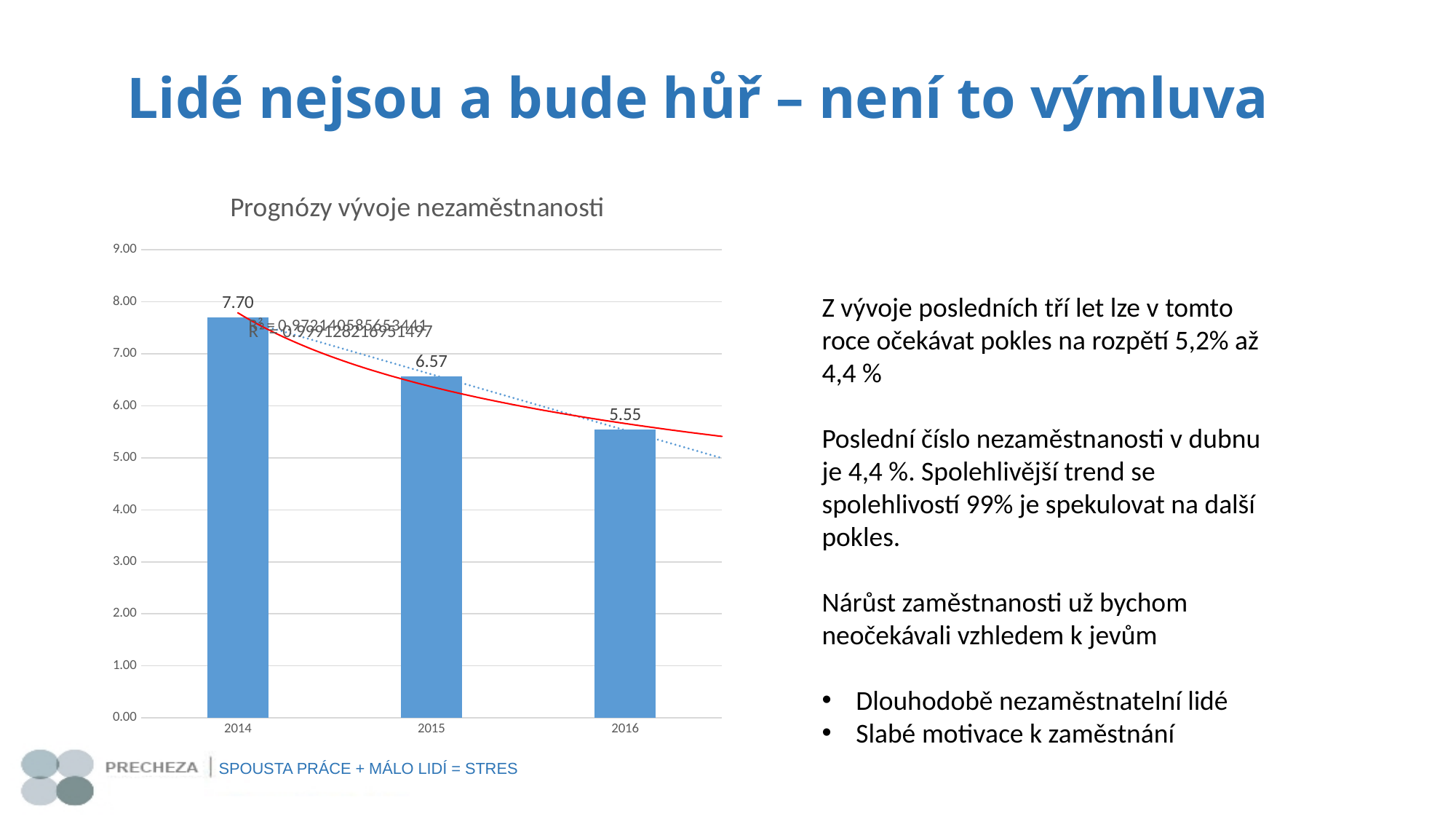
What is the value for 2014? 7.70 How many years are shown on the x axis? 3 Is the value for 2016 greater or less than 6.00? less What is the value for 2016? 5.55 What is the difference between the values for 2014 and 2016? 2.15 What kind of chart is this? bar chart What is the difference between the values for 2014 and 2015? 1.13 Which year has the lowest value? 2016 What is the value for 2015? 6.57 Which year has the highest value? 2014 Which is larger, the value for 2015 or the value for 2016? 2015 Do the values rise or fall from 2014 to 2016? fall